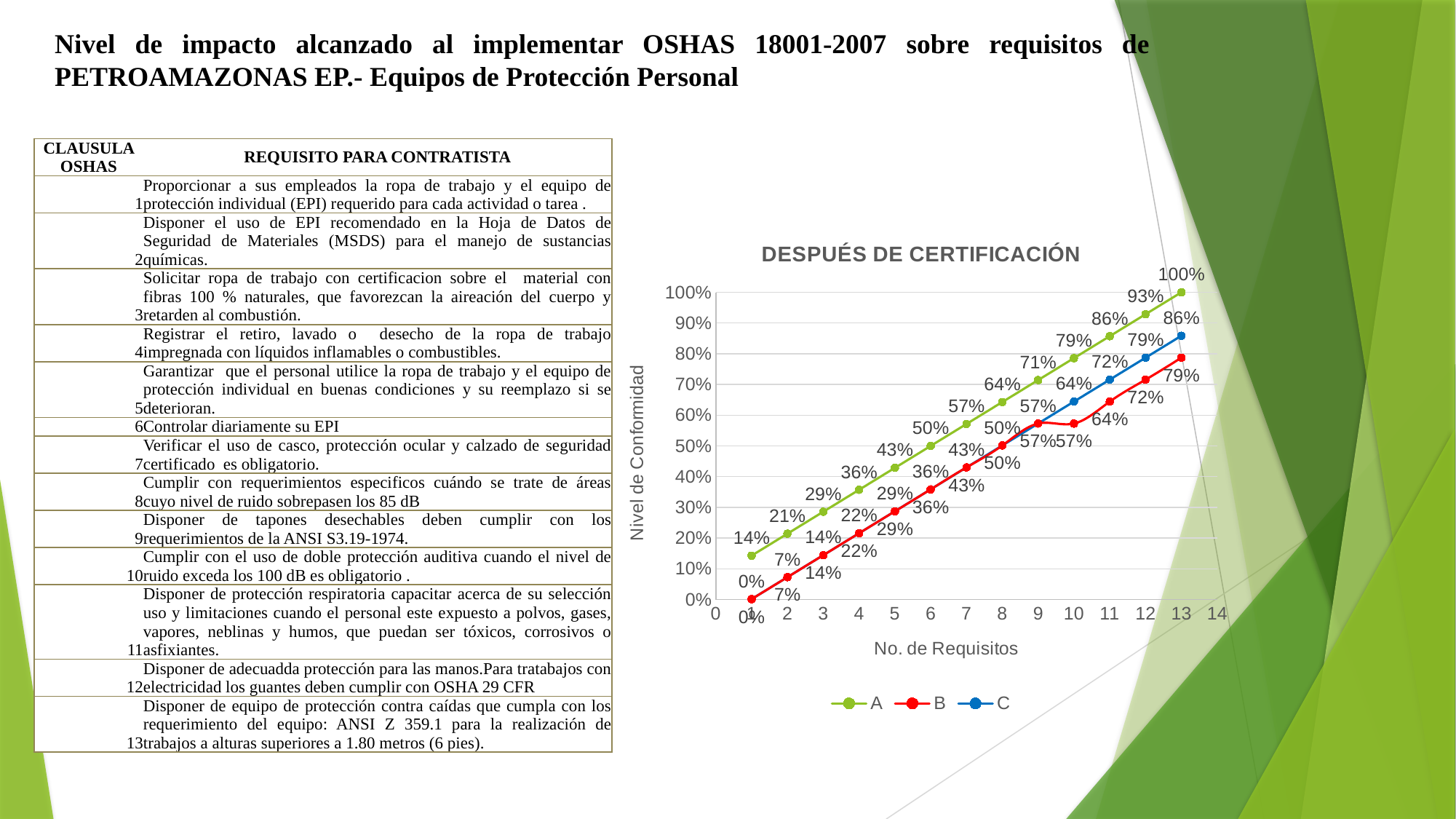
What is the value of series A at requisito 13? 100% What is the title of the chart on the slide? DESPUÉS DE CERTIFICACIÓN What is the value of series A at requisito 1? 14% What is the label of the y axis of the chart? Nivel de Conformidad Which series has the higher value at requisito 7, A or B? A What is the value of series B at requisito 13? 79% Do the values of series A rise or fall as the number of requisitos increases? rise What is the value of series B at requisito 1? 0% What kind of chart is shown on the slide? line chart What is the difference between series A and series B at requisito 13? 21% How many series does the chart legend list? 3 What is the value of series C at requisito 13? 86%